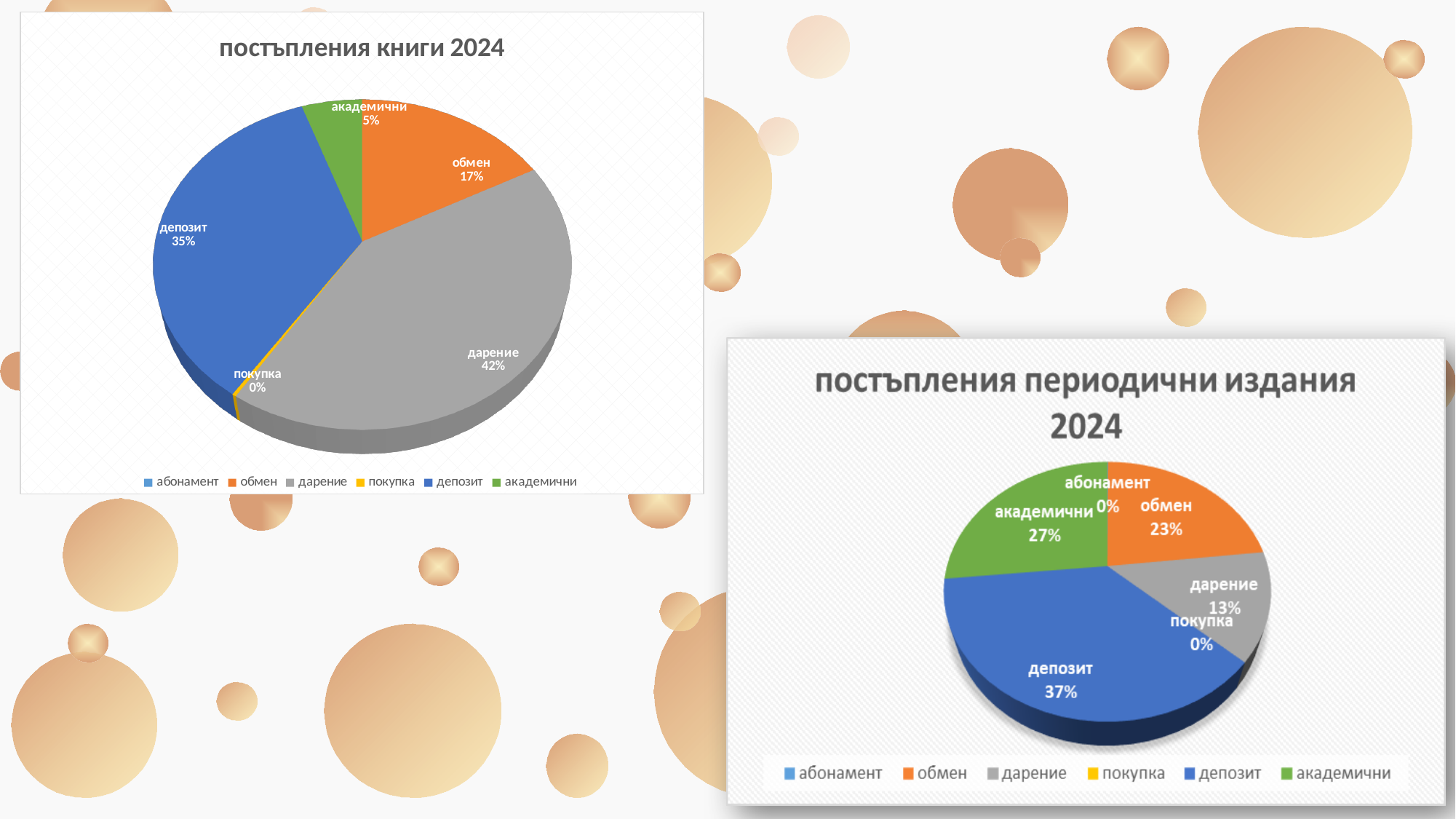
In the chart titled "постъпления книги 2024", what share does "депозит" have? 35% In the chart titled "постъпления периодични издания 2024", what share does "депозит" have? 37% In the chart titled "постъпления периодични издания 2024", which category has the largest share? депозит In the chart titled "постъпления периодични издания 2024", which is larger, "обмен" or "дарение"? обмен In the chart titled "постъпления периодични издания 2024", what colour is the "академични" slice? green What kind of chart is "постъпления книги 2024"? pie chart In the chart titled "постъпления книги 2024", what share does "дарение" have? 42% In the chart titled "постъпления книги 2024", how many entries does the legend list? 6 In the chart titled "постъпления книги 2024", which labelled category has the largest share? дарение In the chart titled "постъпления книги 2024", what is the difference between the shares of "дарение" and "обмен"? 25% In the chart titled "постъпления периодични издания 2024", what is the difference between the shares of "депозит" and "дарение"? 24%